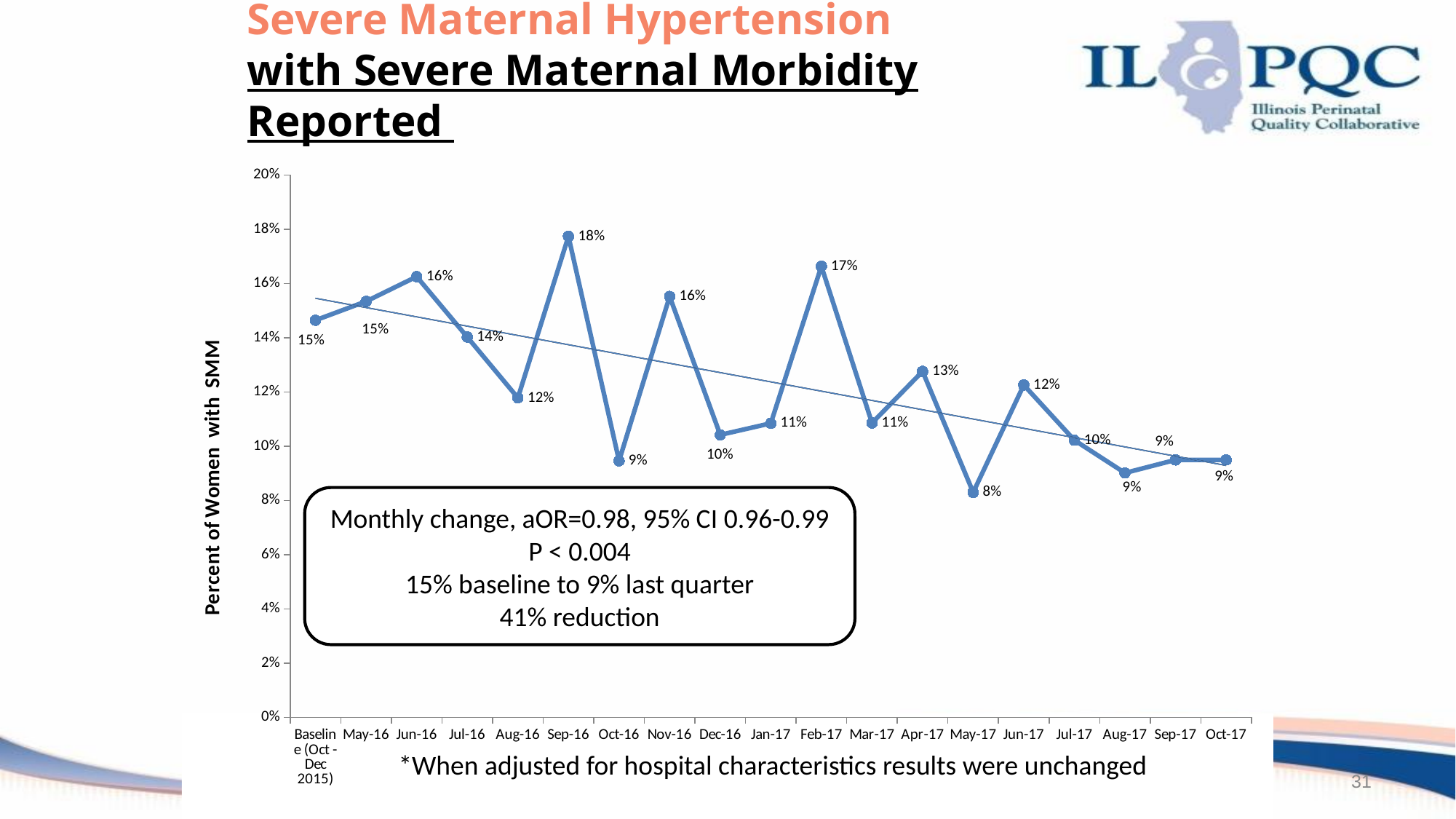
What kind of chart is shown on the slide? line chart Is the value for Nov-16 greater or less than 14%? greater Which is larger, the value for Feb-17 or the value for Mar-17? Feb-17 Which month has the lowest percent of women with SMM? May-17 What is the value for Sep-16? 18% Which month has the highest percent of women with SMM? Sep-16 What is the value for May-17? 8% Overall, do the values rise or fall from the baseline to Oct-17? fall How many data points are plotted on the chart? 19 What is the difference between the values for Sep-16 and Oct-16? 9 percentage points What is the title of the vertical axis? Percent of Women with SMM What is the value for the Baseline (Oct - Dec 2015) point? 15%